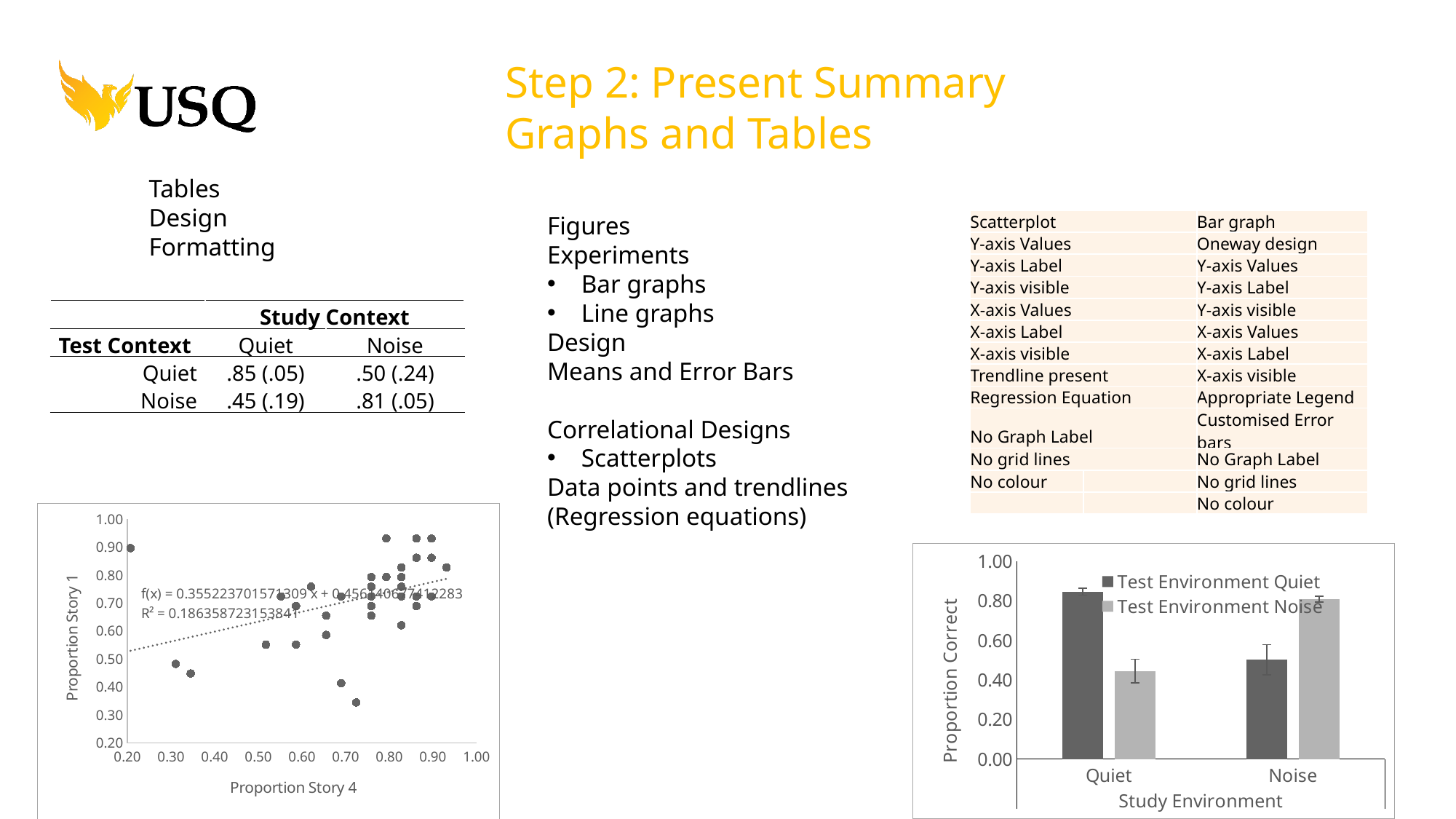
In the bottom-right bar chart, is the Test Environment Quiet value for the Noise study environment greater or less than 0.60? less In the bottom-left scatter plot, does the trendline rise or fall as Proportion Story 4 increases? rises In the bottom-right bar chart, which series has the taller bar for the Quiet study environment? Test Environment Quiet In the bottom-right bar chart, is the Test Environment Noise value for the Quiet study environment greater or less than 0.60? less In the bottom-right bar chart, is the Test Environment Quiet value for the Quiet study environment greater or less than 0.60? greater What kind of chart is the bottom-right chart with the x-axis 'Study Environment'? bar chart In the bottom-right bar chart, which series has the taller bar for the Noise study environment? Test Environment Noise In the bottom-right bar chart, how many series does the legend list? 2 In the bottom-left scatter plot, what is the R² value shown for the trendline? 0.186358723153841 What kind of chart is the bottom-left chart with the x-axis 'Proportion Story 4'? scatter plot In the bottom-right bar chart, how many categories are shown on the x-axis? 2